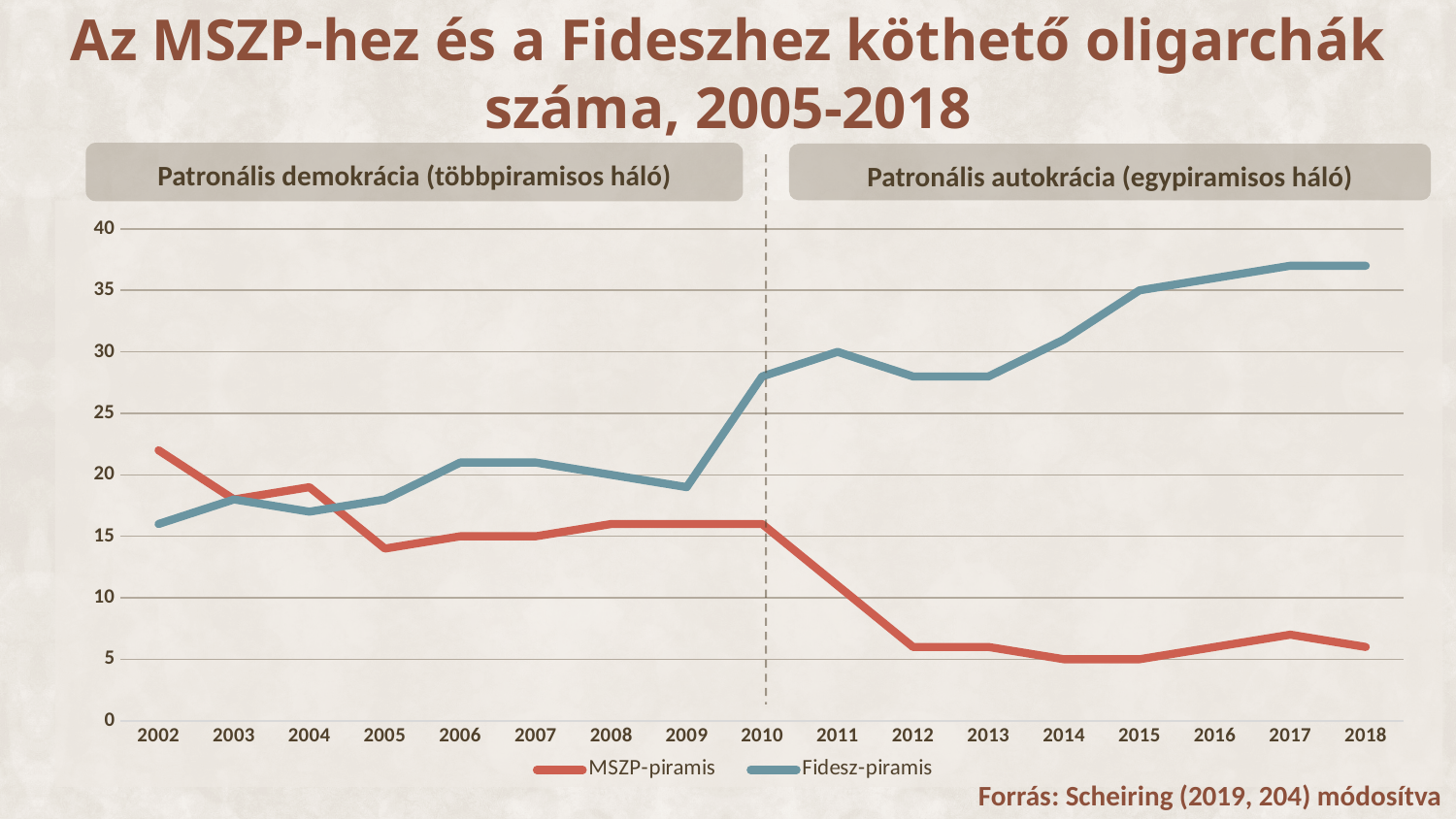
What is the value of the Fidesz-piramis series in 2015? 35 Is the value for MSZP-piramis in 2012 greater or less than 10? less How many series does the legend list? 2 What kind of chart is shown on the slide? line chart How many years are plotted along the x axis? 17 Is the value for MSZP-piramis in 2002 greater or less than 20? greater Is the value for Fidesz-piramis in 2018 greater or less than 35? greater What is the value of the MSZP-piramis series in 2014? 5 Which series has the larger value in 2010, MSZP-piramis or Fidesz-piramis? Fidesz-piramis What is the value of the Fidesz-piramis series in 2011? 30 In which year does the MSZP-piramis series reach its highest value? 2002 Does the Fidesz-piramis series generally rise or fall from 2010 to 2018? rise